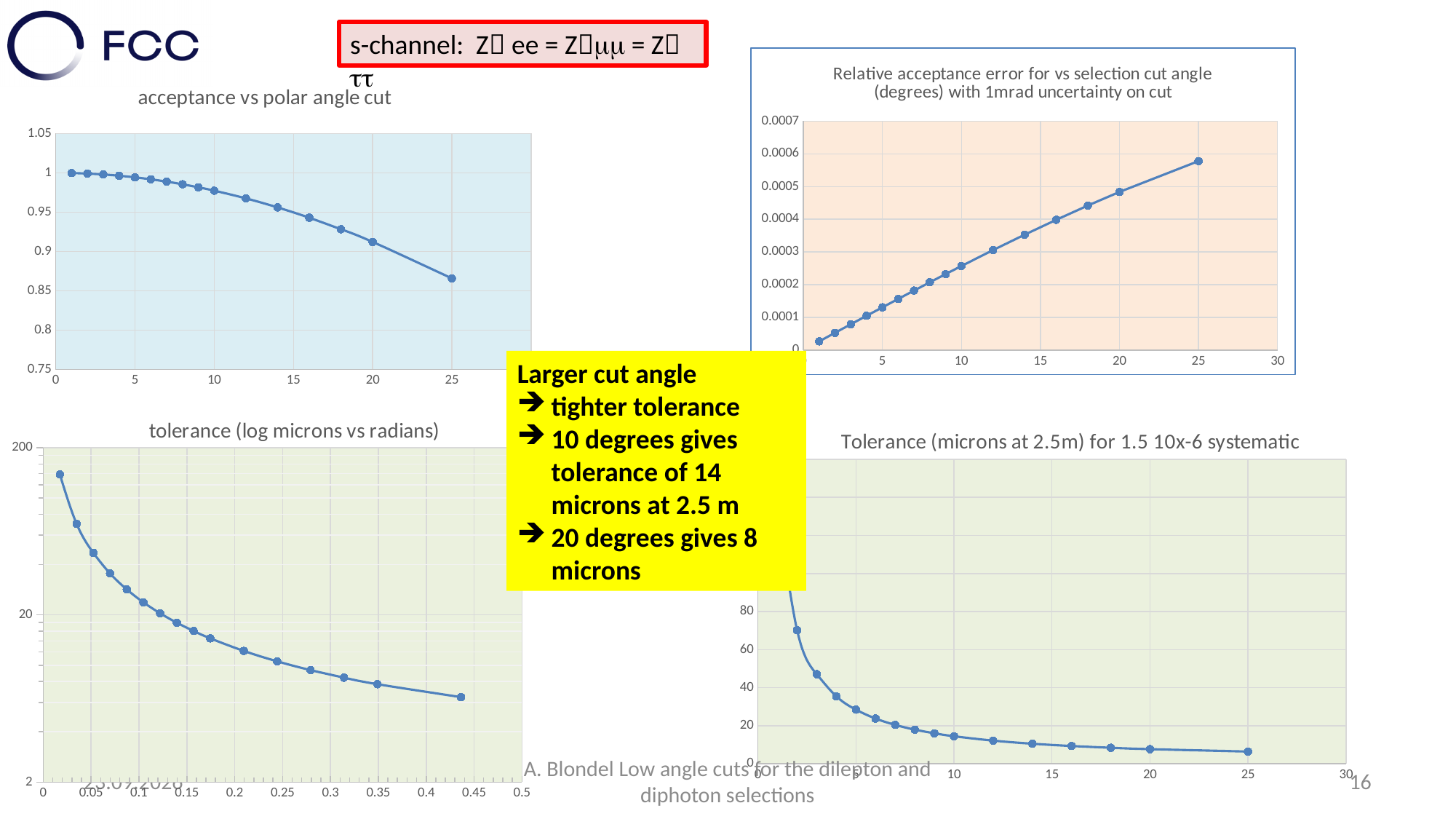
What kind of chart is the 'acceptance vs polar angle cut' chart? line chart In the 'tolerance (log microns vs radians)' chart, is the value at the first point (near x = 0.02) greater or less than 20? greater In the 'Tolerance (microns at 2.5m) for 1.5 10x-6 systematic' chart, is the value at a cut angle of 25 greater or less than 20? less In the 'Tolerance (microns at 2.5m) for 1.5 10x-6 systematic' chart, is the value at a cut angle of 5 greater or less than 20? greater In the 'acceptance vs polar angle cut' chart, do the values rise or fall as the polar angle cut increases? fall In the 'Relative acceptance error' chart at the top right, do the values rise or fall as the selection cut angle increases? rise What is the highest value shown on the y axis of the 'acceptance vs polar angle cut' chart? 1.05 In the 'tolerance (log microns vs radians)' chart, do the values rise or fall as the x value increases? fall